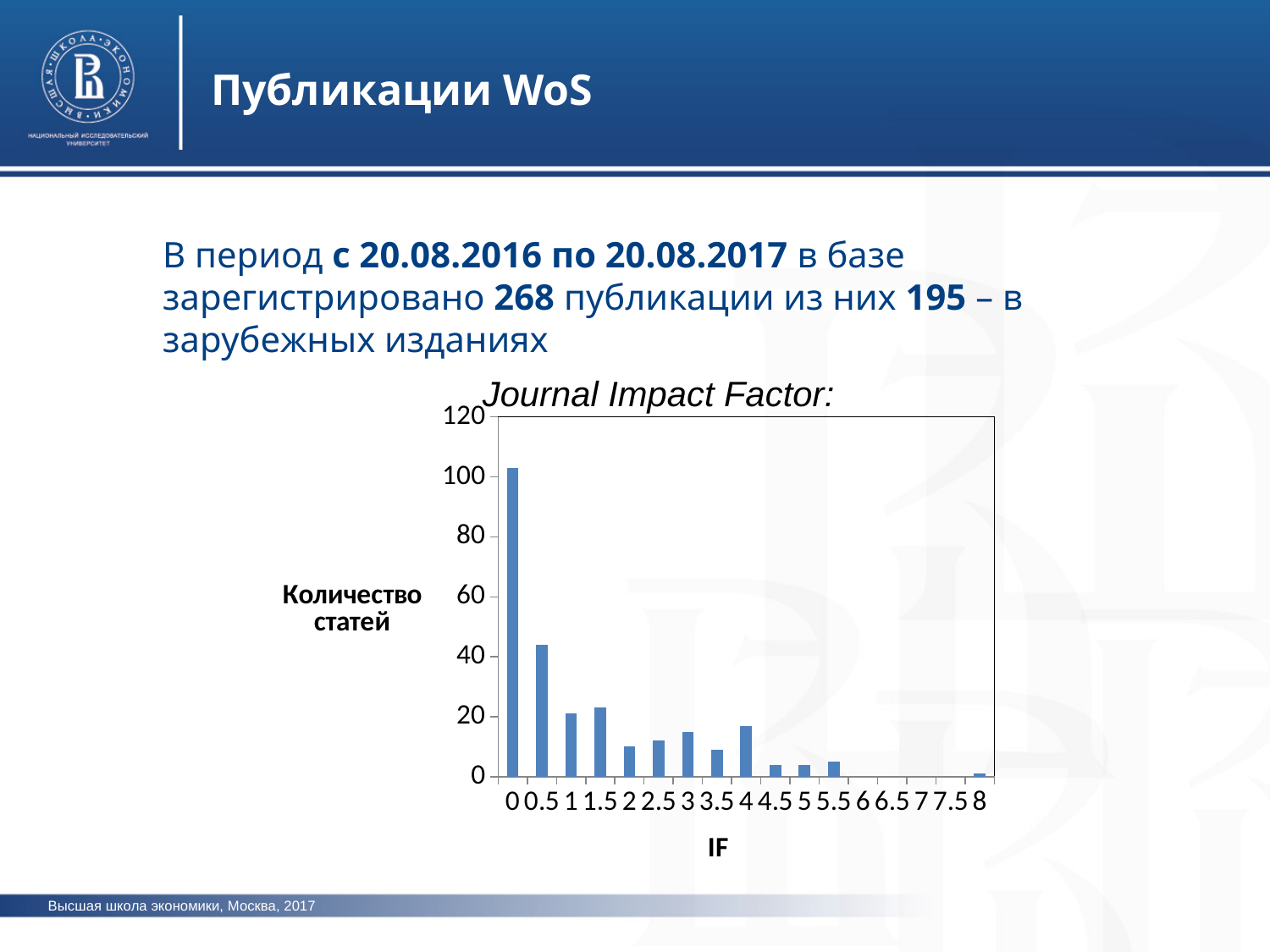
What kind of chart is shown under the title "Journal Impact Factor:"? bar chart Which IF category has the highest number of articles? 0 Is the value for IF 2 greater or less than 20? less How many IF categories are labelled on the x axis? 17 What is the label of the vertical axis of the chart? Количество статей Which has more articles, IF 0 or IF 0.5? 0 Which has more articles, IF 1.5 or IF 2? 1.5 Is the value for IF 4 greater or less than 20? less Is the value for IF 0 greater or less than 100? greater Which has more articles, IF 4 or IF 3.5? 4